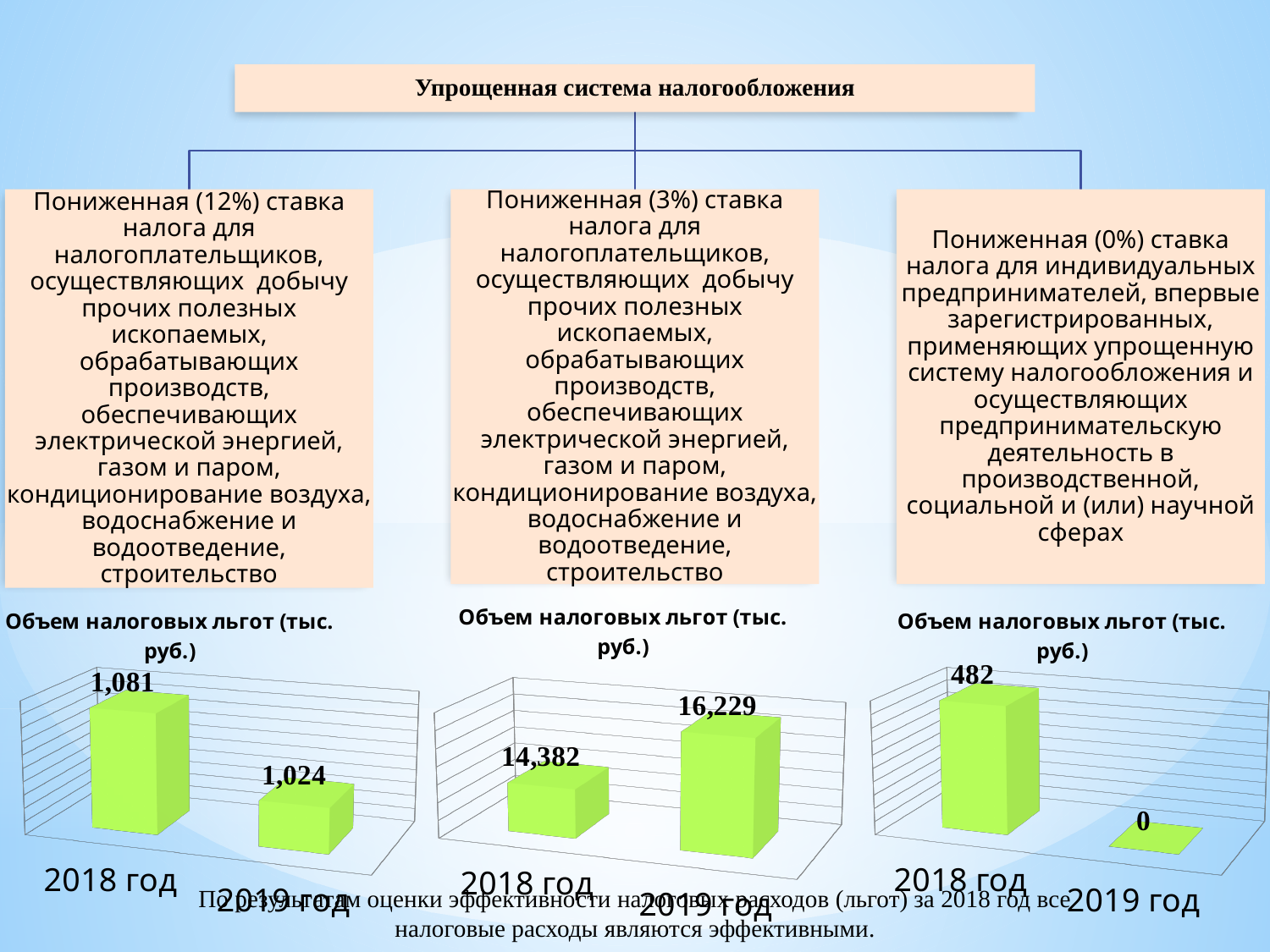
In the middle chart, do the values rise or fall from 2018 год to 2019 год? rise In the right chart, which year has the lower value? 2019 год In the left chart, what is the difference between the 2018 год and 2019 год values? 57 In the middle chart, what is the difference between the 2019 год and 2018 год values? 1,847 In the middle chart, which year has the higher value? 2019 год In the right chart, what is the value for 2019 год? 0 In the right chart, what is the value for 2018 год? 482 In the left chart, what is the value for 2018 год? 1,081 In the left chart, what is the value for 2019 год? 1,024 In the middle chart, what is the value for 2018 год? 14,382 In the middle chart, what is the value for 2019 год? 16,229 What type of chart is the left chart? bar chart